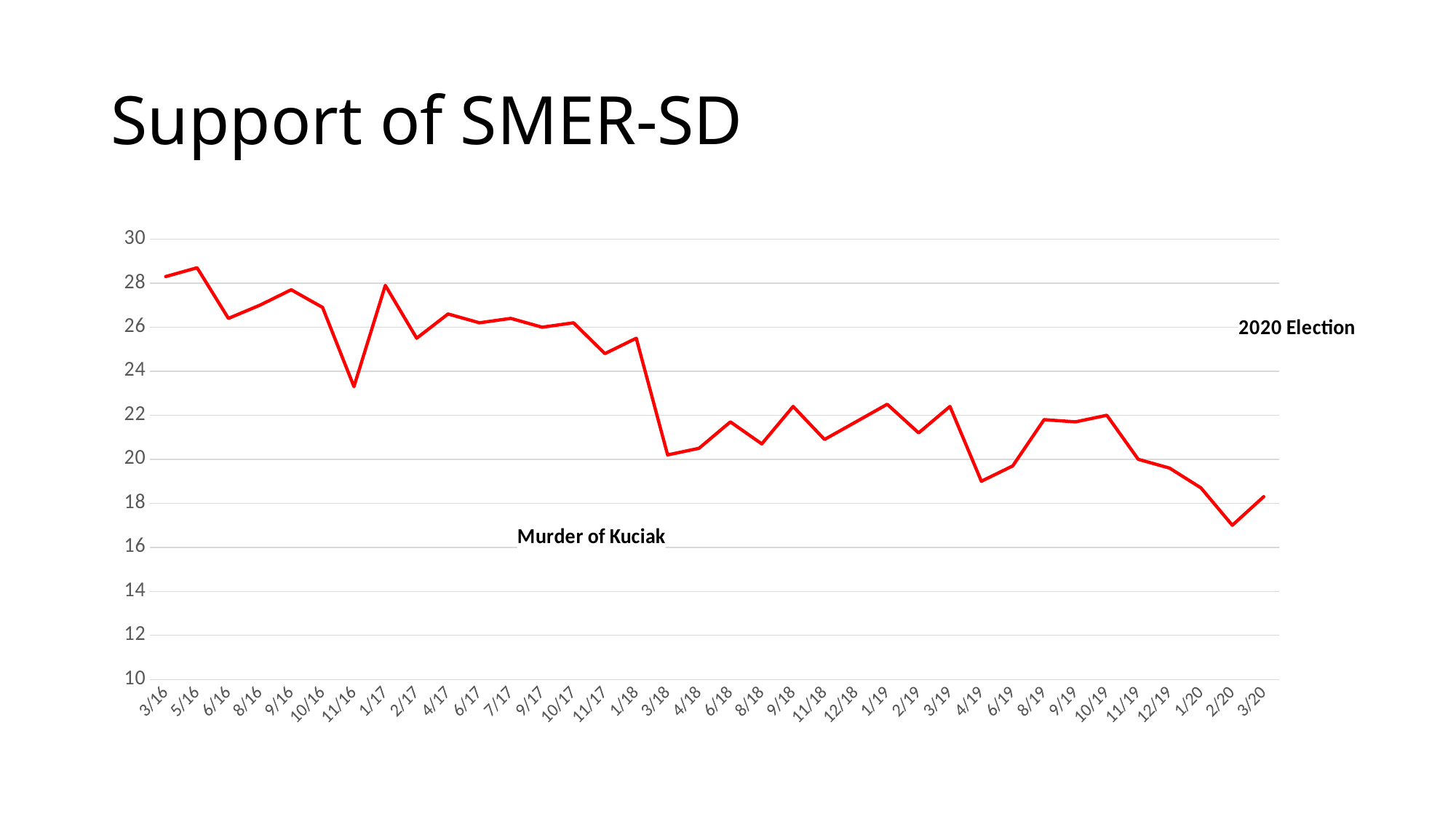
Is the value for 3/18 greater or less than 22? less Is the value for 3/16 greater or less than 26? greater Is the value for 1/17 greater or less than 26? greater What event is annotated on the chart near the sharp drop between 1/18 and 3/18? Murder of Kuciak Which is larger, the value for 3/16 or the value for 3/20? 3/16 What kind of chart is shown on the slide? line chart Overall, does the support of SMER-SD rise or fall from 3/16 to 3/20? fall At which time point is the support of SMER-SD lowest? 2/20 At which time point is the support of SMER-SD highest? 5/16 Which is larger, the value for 1/18 or the value for 3/18? 1/18 How many time points are plotted along the x axis? 36